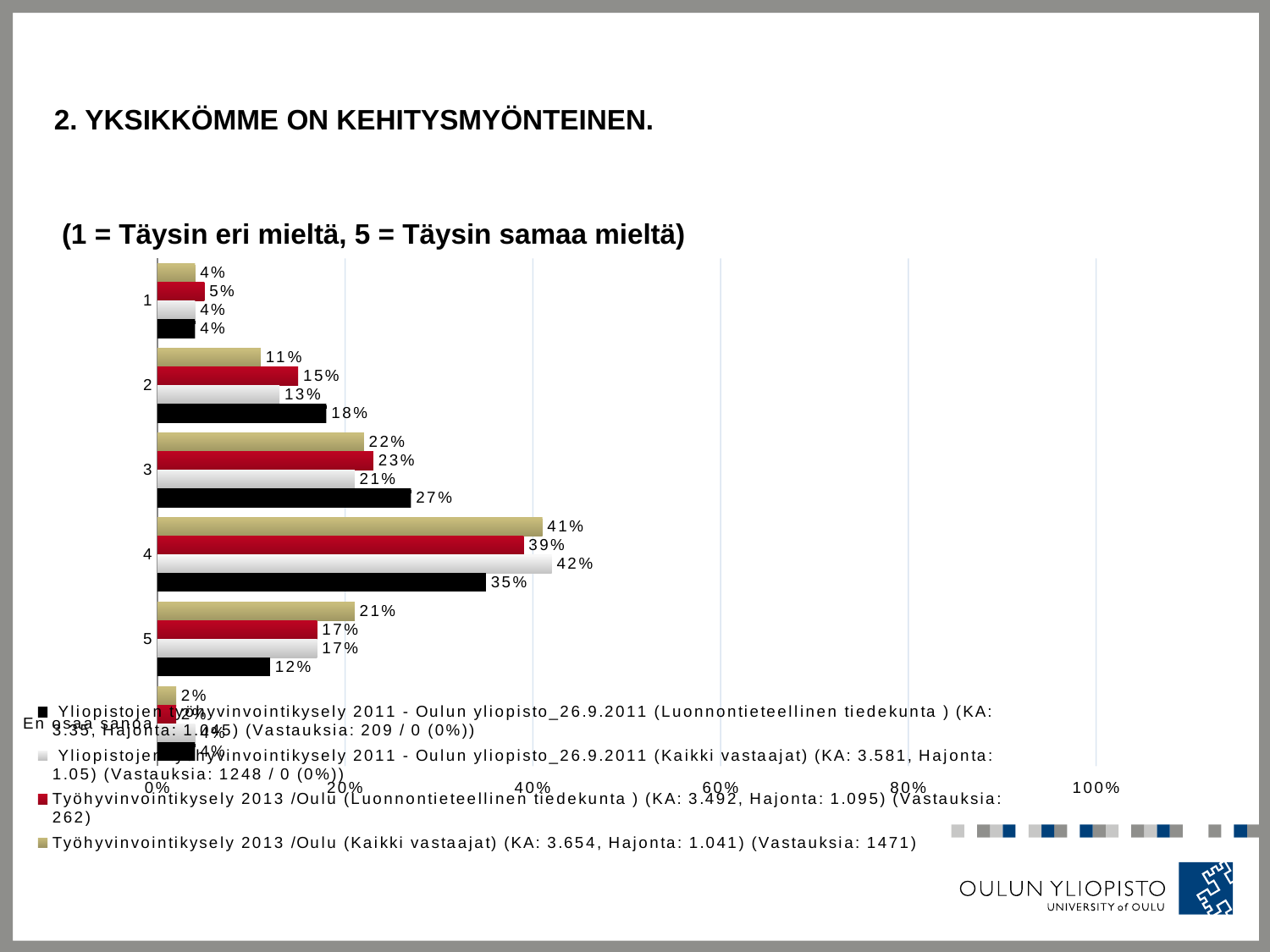
What is the value for category 3 in the series 'Yliopistojen työhyvinvointikysely 2011 - Oulun yliopisto_26.9.2011 (Kaikki vastaajat)'? 21% Is the value for category 4 in the series 'Työhyvinvointikysely 2013 /Oulu (Luonnontieteellinen tiedekunta)' greater or less than 20%? greater What is the difference between the 2013 Kaikki vastaajat value and the 2011 Luonnontieteellinen tiedekunta value for category 5? 9% What colour are the bars for the series 'Työhyvinvointikysely 2013 /Oulu (Luonnontieteellinen tiedekunta)'? red What is the value for category 2 in the series 'Yliopistojen työhyvinvointikysely 2011 - Oulun yliopisto_26.9.2011 (Luonnontieteellinen tiedekunta)'? 18% Which category has the highest value in the series 'Työhyvinvointikysely 2013 /Oulu (Kaikki vastaajat)'? 4 What is the value for category 5 in the series 'Työhyvinvointikysely 2013 /Oulu (Luonnontieteellinen tiedekunta)'? 17% What is the difference between the 2011 Luonnontieteellinen tiedekunta value and the 2013 Kaikki vastaajat value for category 2? 7% What type of chart is shown on the slide? bar chart How many series does the legend list? 4 What is the value for category 4 in the series 'Työhyvinvointikysely 2013 /Oulu (Kaikki vastaajat)'? 41% For category 4, which is larger: the 2011 Kaikki vastaajat value or the 2011 Luonnontieteellinen tiedekunta value? 2011 Kaikki vastaajat (42%)